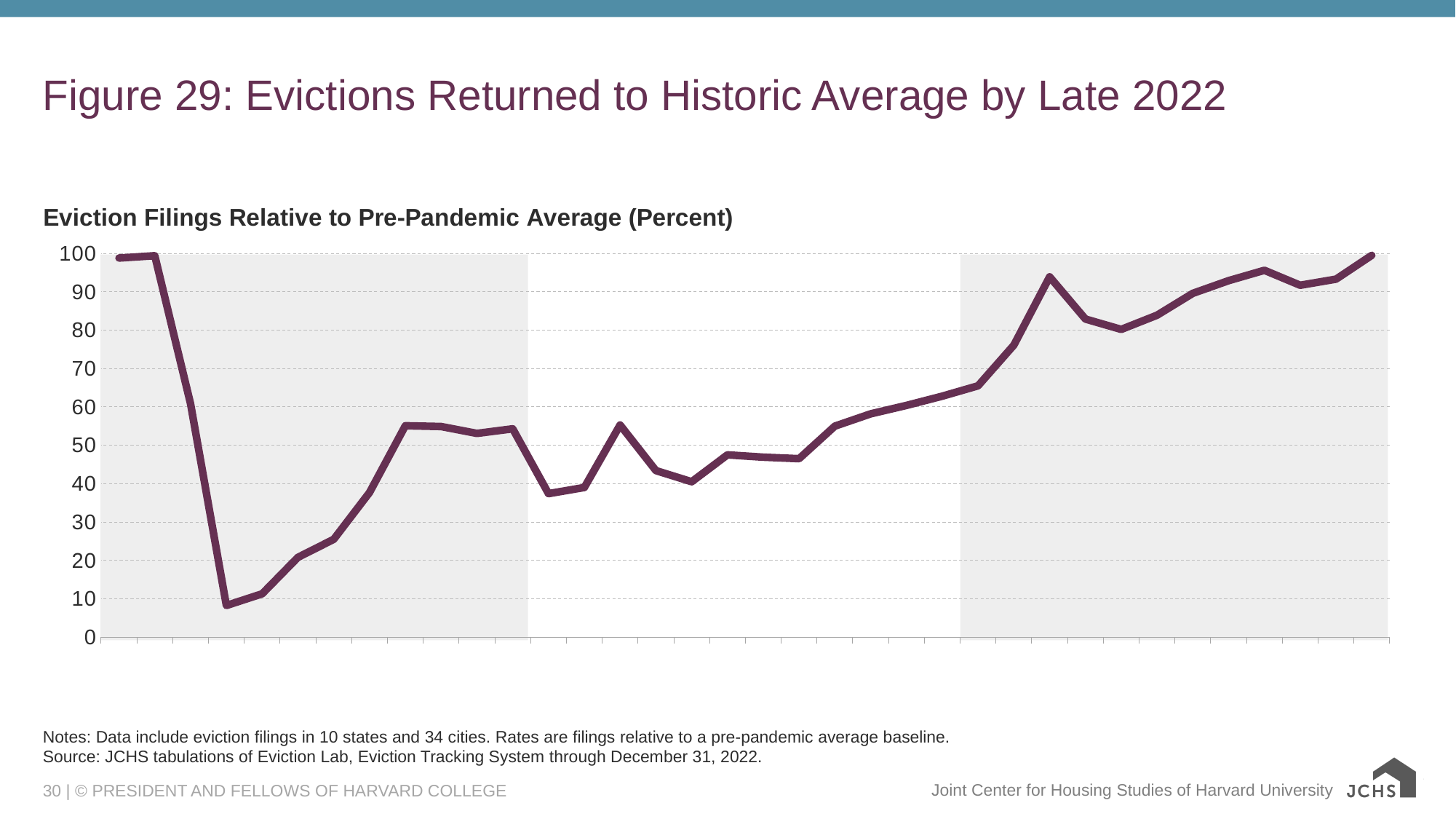
Is the lowest point on the line greater or less than 10? less What kind of chart is shown on the slide? line chart What is the highest value shown on the vertical axis of the chart? 100 What is the title of the chart on the slide? Eviction Filings Relative to Pre-Pandemic Average (Percent) Is the last point on the line greater or less than 90? greater How many lines are plotted on the chart? 1 Which is larger: the first point on the line or the lowest point on the line? the first point Within the right-hand shaded region of the chart, do the values generally rise or fall from left to right? rise Is the first point on the line greater or less than 90? greater